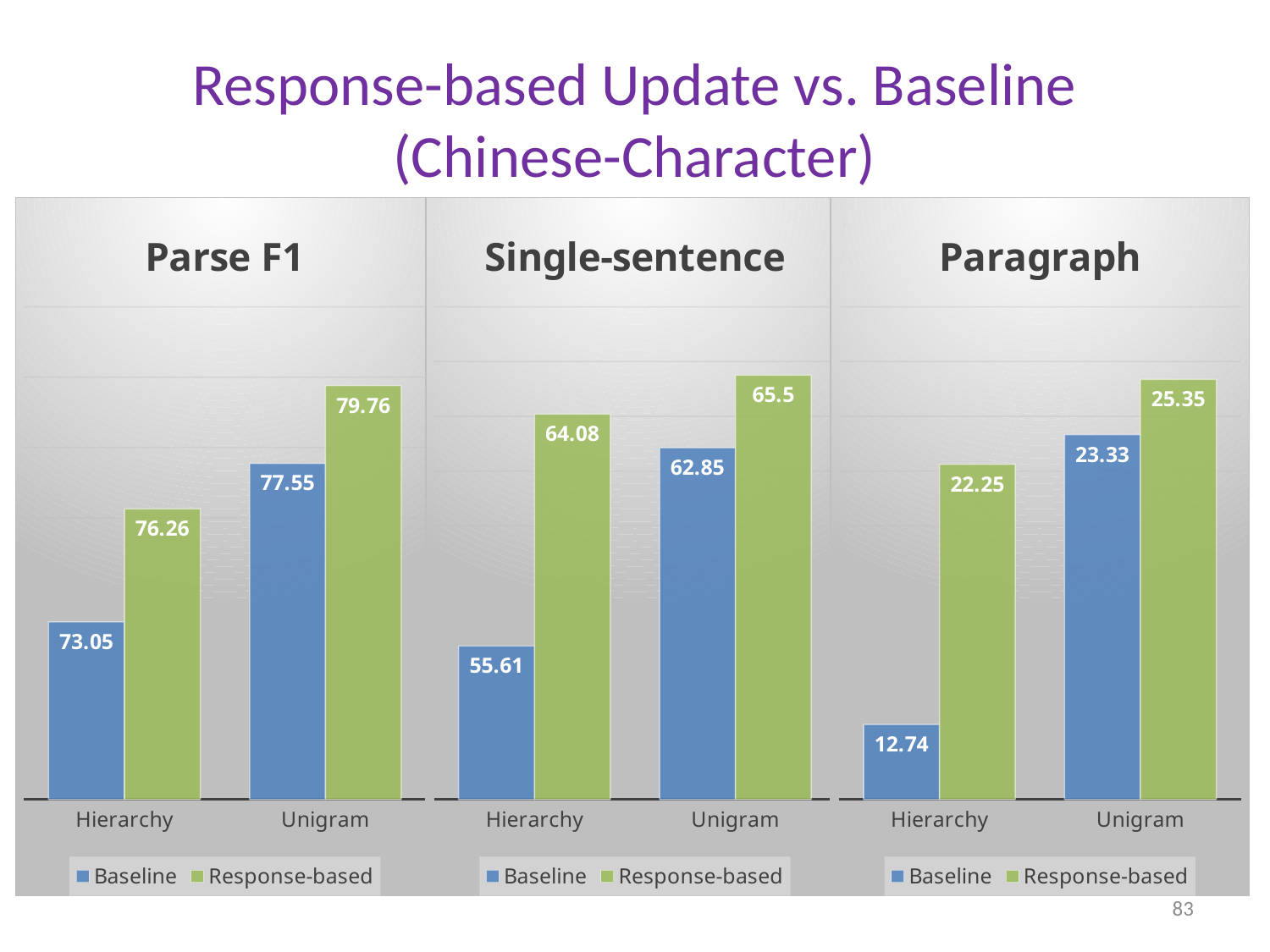
In the Paragraph chart, which bar is the lowest? Baseline for Hierarchy In the Parse F1 chart, what is the Response-based value for Unigram? 79.76 In the Paragraph chart, which is larger: the Baseline value for Unigram or the Response-based value for Hierarchy? Baseline value for Unigram In the Paragraph chart, what is the Response-based value for Unigram? 25.35 In the Single-sentence chart, what is the Response-based value for Hierarchy? 64.08 In the Parse F1 chart, what is the Baseline value for Hierarchy? 73.05 What kind of chart is the Single-sentence chart? Bar chart In the Parse F1 chart, what is the difference between the Response-based and Baseline values for Unigram? 2.21 In the Paragraph chart, what is the Baseline value for Hierarchy? 12.74 In the Single-sentence chart, what is the difference between the Response-based and Baseline values for Hierarchy? 8.47 How many series does the legend of the Parse F1 chart list? 2 In the Single-sentence chart, which bar is the highest? Response-based for Unigram